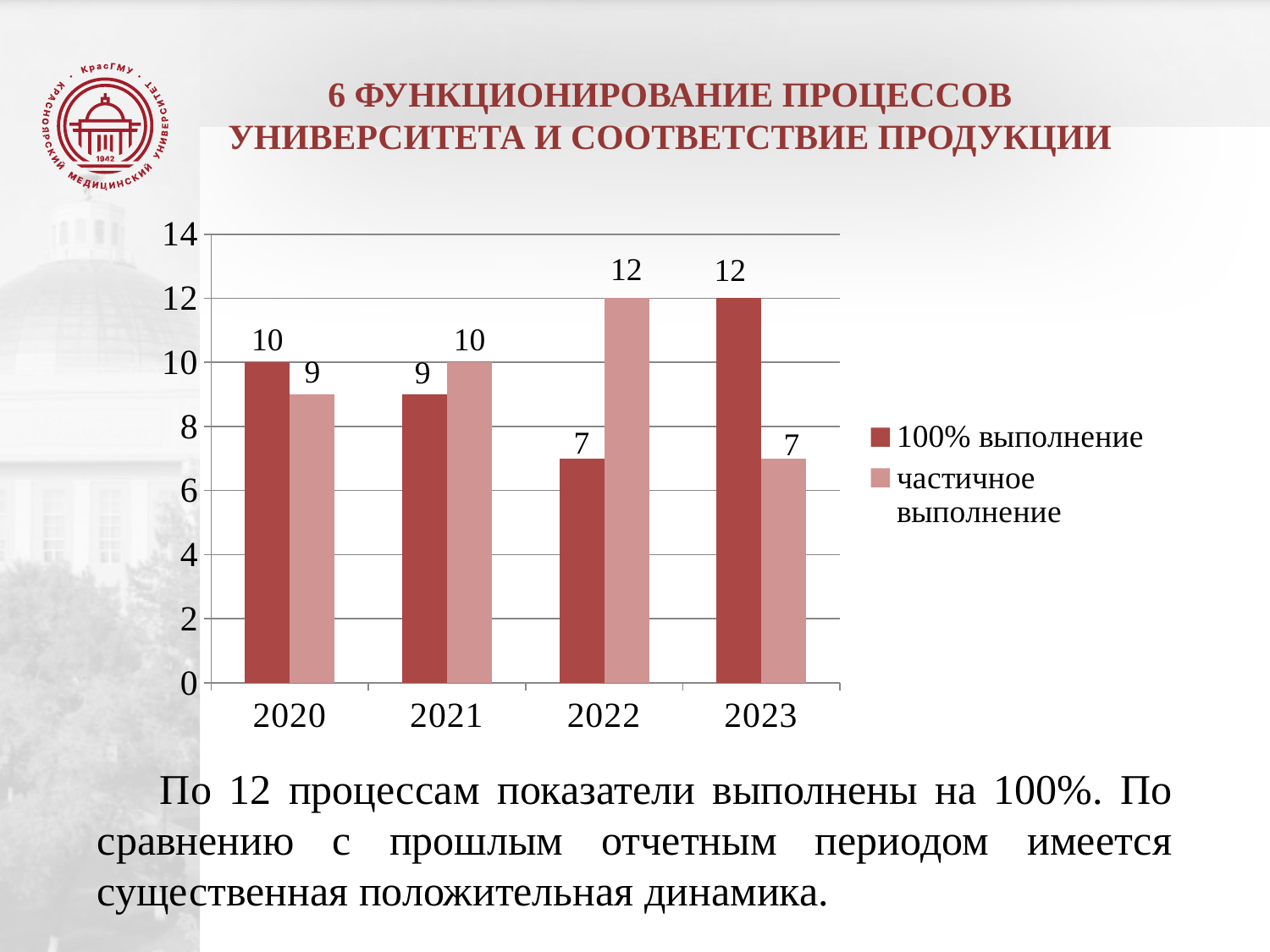
What is the value for "частичное выполнение" in 2021? 10 How many years are shown on the x axis? 4 What kind of chart is shown on the slide? bar chart What is the difference between "100% выполнение" and "частичное выполнение" in 2022? 5 Is the value for "частичное выполнение" in 2023 greater or less than 8? less How many series does the legend list? 2 What is the value for "100% выполнение" in 2022? 7 In which year is the value for "частичное выполнение" highest? 2022 In which year is the value for "100% выполнение" lowest? 2022 What is the value for "100% выполнение" in 2023? 12 In which year is the value for "100% выполнение" highest? 2023 Which is larger in 2020: "100% выполнение" or "частичное выполнение"? 100% выполнение